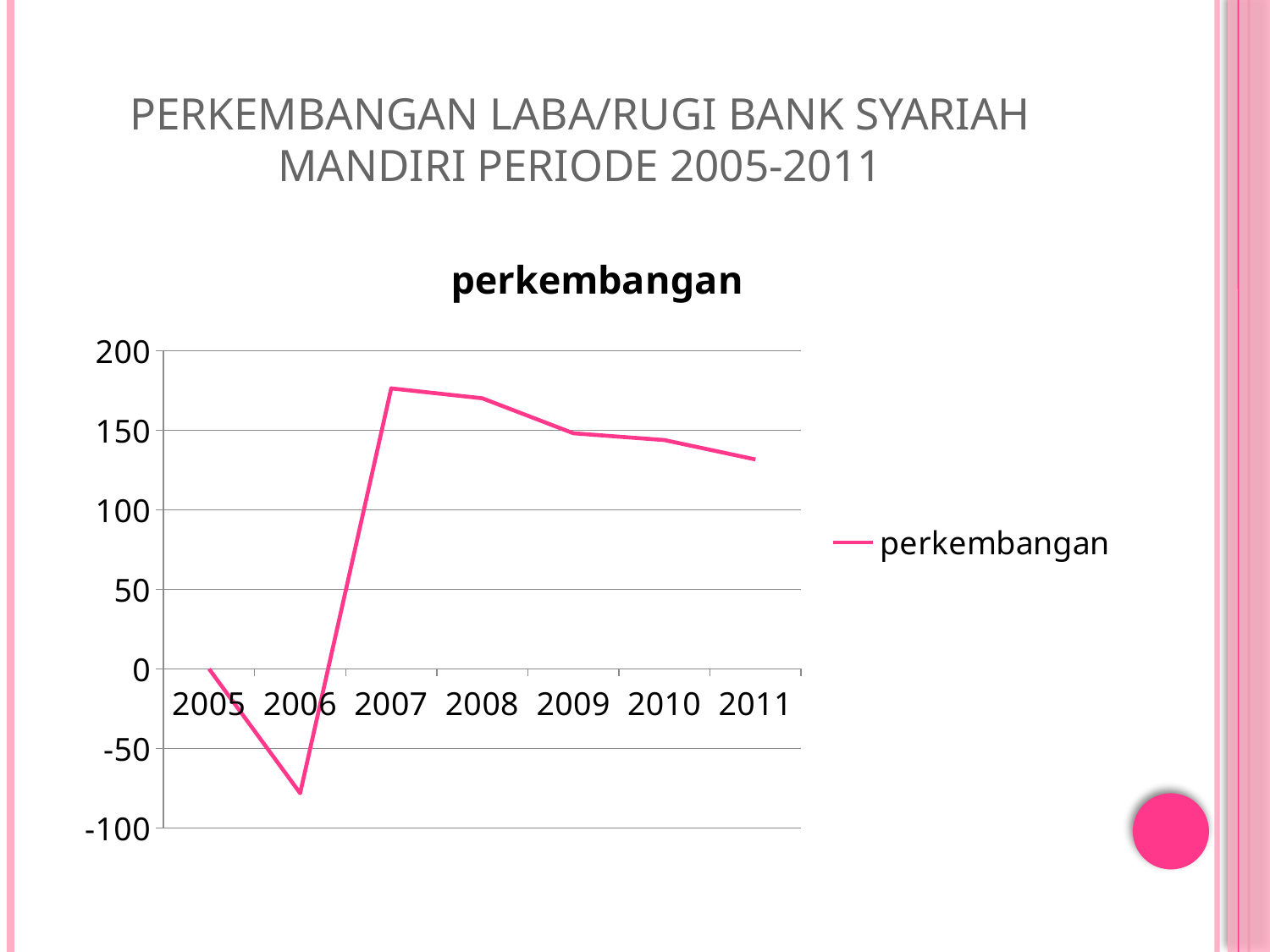
Do the values rise or fall from 2007 to 2011? fall Which year has the lowest value for perkembangan? 2006 Which year has the highest value for perkembangan? 2007 Is the value for 2006 greater or less than -50? less Is the value for 2011 greater or less than 100? greater What is the title of the chart? perkembangan Is the value for 2006 greater or less than 0? less What kind of chart is shown on the slide? line chart How many series does the legend list? 1 Which is larger, the value for 2007 or the value for 2011? 2007 How many years are plotted on the x axis of the chart? 7